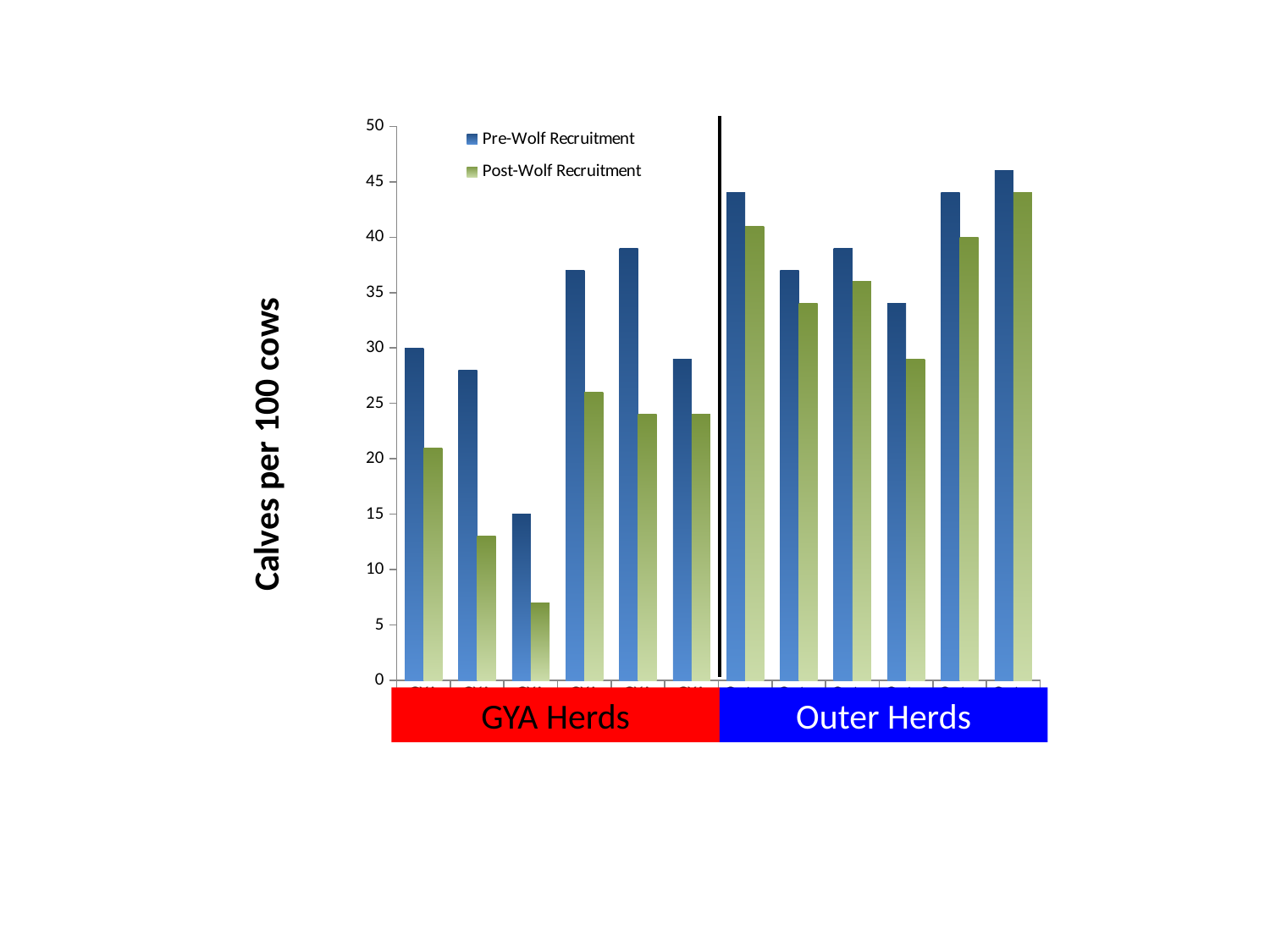
How many herd groups are in the GYA Herds section? 6 For the third GYA herd from the left, which is larger: the Pre-Wolf Recruitment or the Post-Wolf Recruitment value? Pre-Wolf Recruitment What is the label on the vertical axis? Calves per 100 cows What kind of chart is shown on the slide? bar chart Is the Post-Wolf Recruitment value for the first Outer herd (just right of the black divider) greater or less than 35? greater How many series does the legend list? 2 Is the Post-Wolf Recruitment value for the third GYA herd from the left greater or less than 10? less Which herd group has the lowest Post-Wolf Recruitment value? the third GYA herd from the left How many herd groups (pairs of bars) are plotted in total? 12 Is the Pre-Wolf Recruitment value for the rightmost Outer herd greater or less than 40? greater What are the two series named in the legend? Pre-Wolf Recruitment and Post-Wolf Recruitment